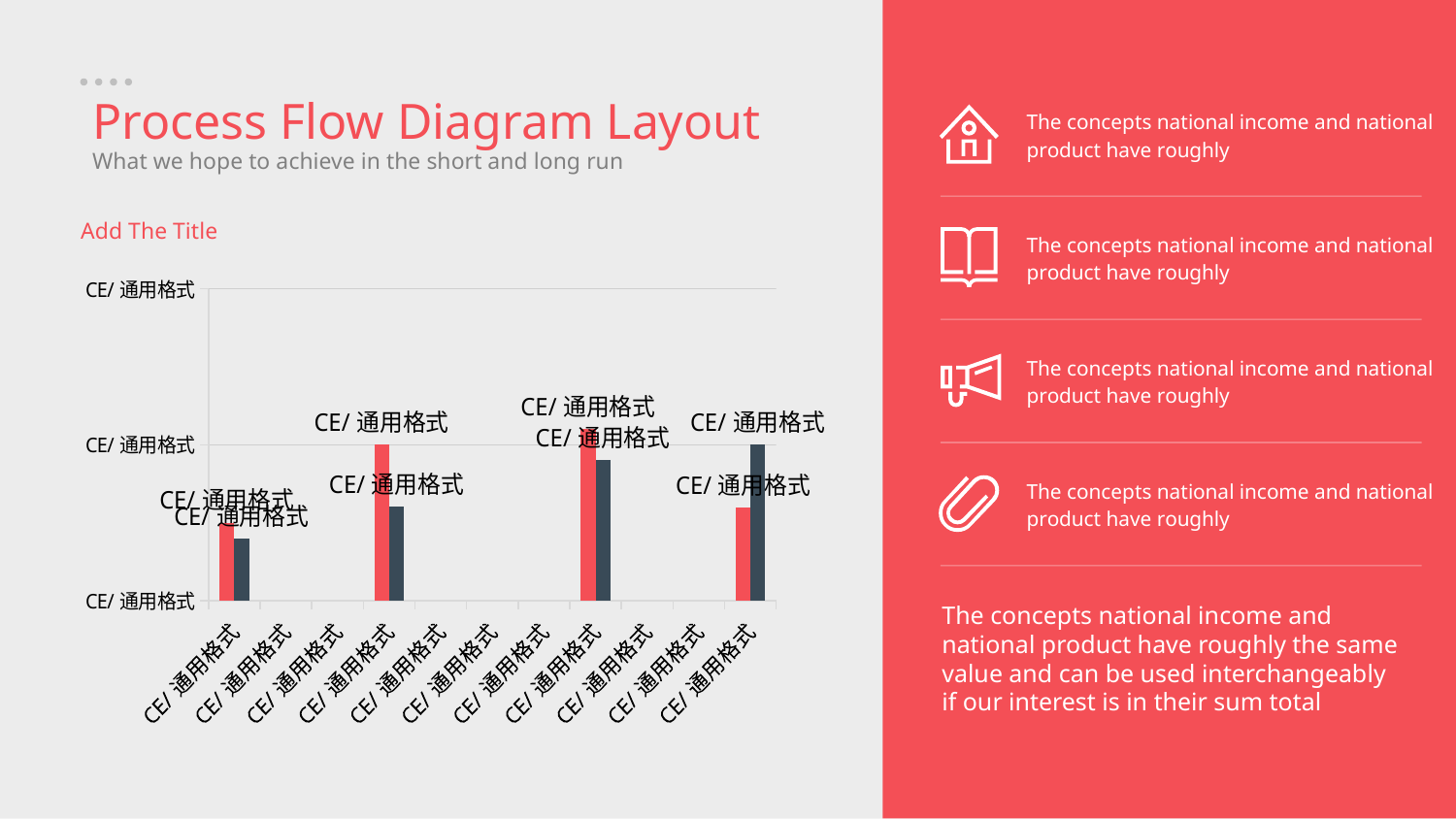
In the rightmost group of bars, which bar is taller, the red one or the dark gray one? the dark gray one Which group of bars, counting from the left, has the shortest dark gray bar? the first group How many data series (bar colours) are plotted in the chart? 2 How many groups of bars are plotted in the chart? 4 What two colours are used for the bars in the chart? red and dark gray Is the red bar in the second group from the left taller or shorter than the red bar in the first group? taller What heading appears directly above the chart? Add The Title In the leftmost group of bars, which bar is taller, the red one or the dark gray one? the red one What kind of chart is shown on the slide? bar chart Which group of bars, counting from the left, has the shortest red bar? the first group